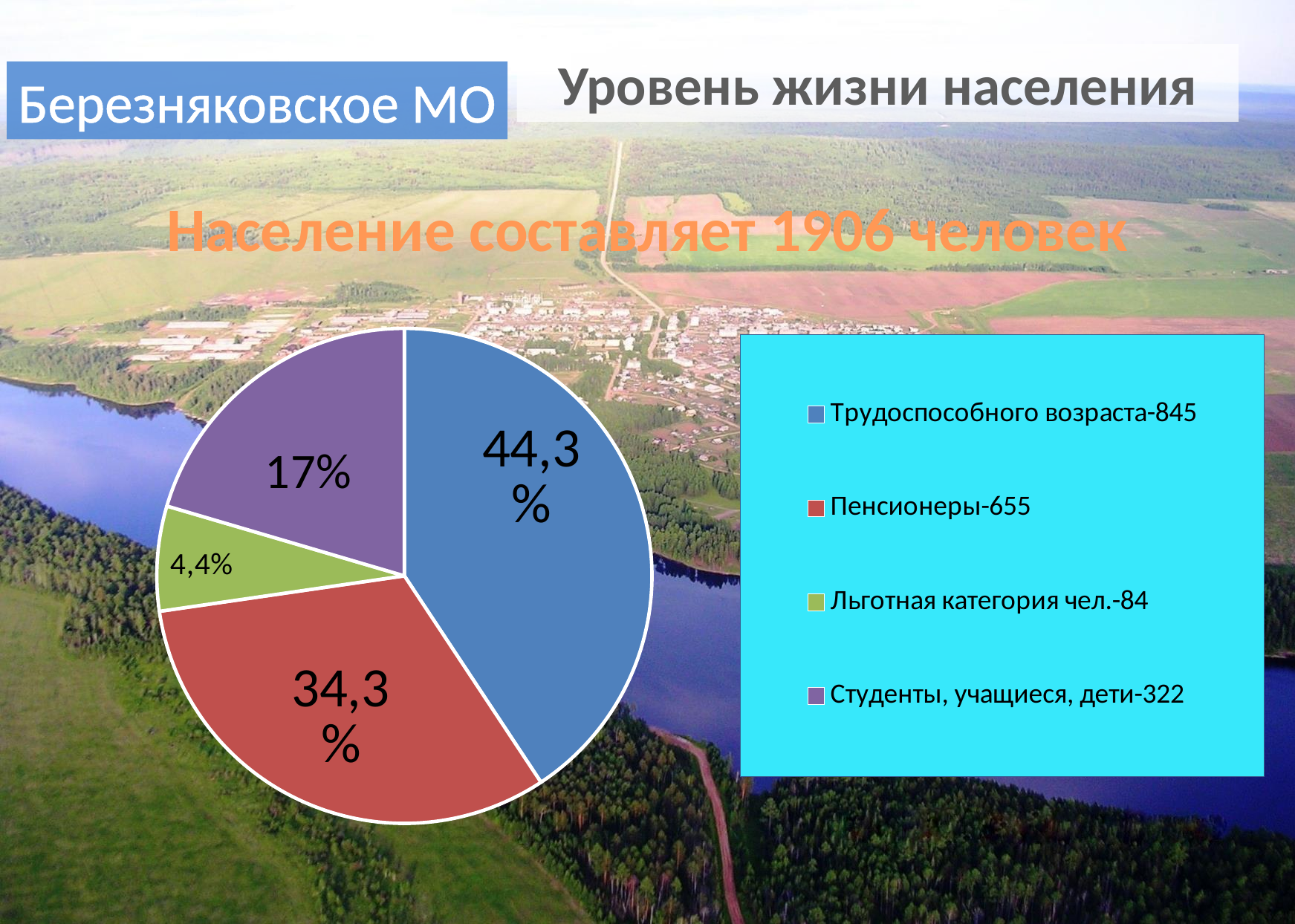
According to the legend, how many people are in the category "Пенсионеры"? 655 What percentage share is shown for the slice "Студенты, учащиеся, дети"? 17% What is the difference in percentage points between the "Трудоспособного возраста" slice and the "Пенсионеры" slice? 10 percentage points Which category has the smallest slice of the pie? Льготная категория чел. Which category has the largest slice of the pie? Трудоспособного возраста What kind of chart is shown on the slide? pie chart How many slices does the pie chart have? 4 What colour is the slice for "Студенты, учащиеся, дети"? purple What percentage share is shown for the slice "Пенсионеры"? 34,3% What percentage share is shown for the slice "Льготная категория чел."? 4,4% Which slice is larger: "Пенсионеры" or "Студенты, учащиеся, дети"? Пенсионеры